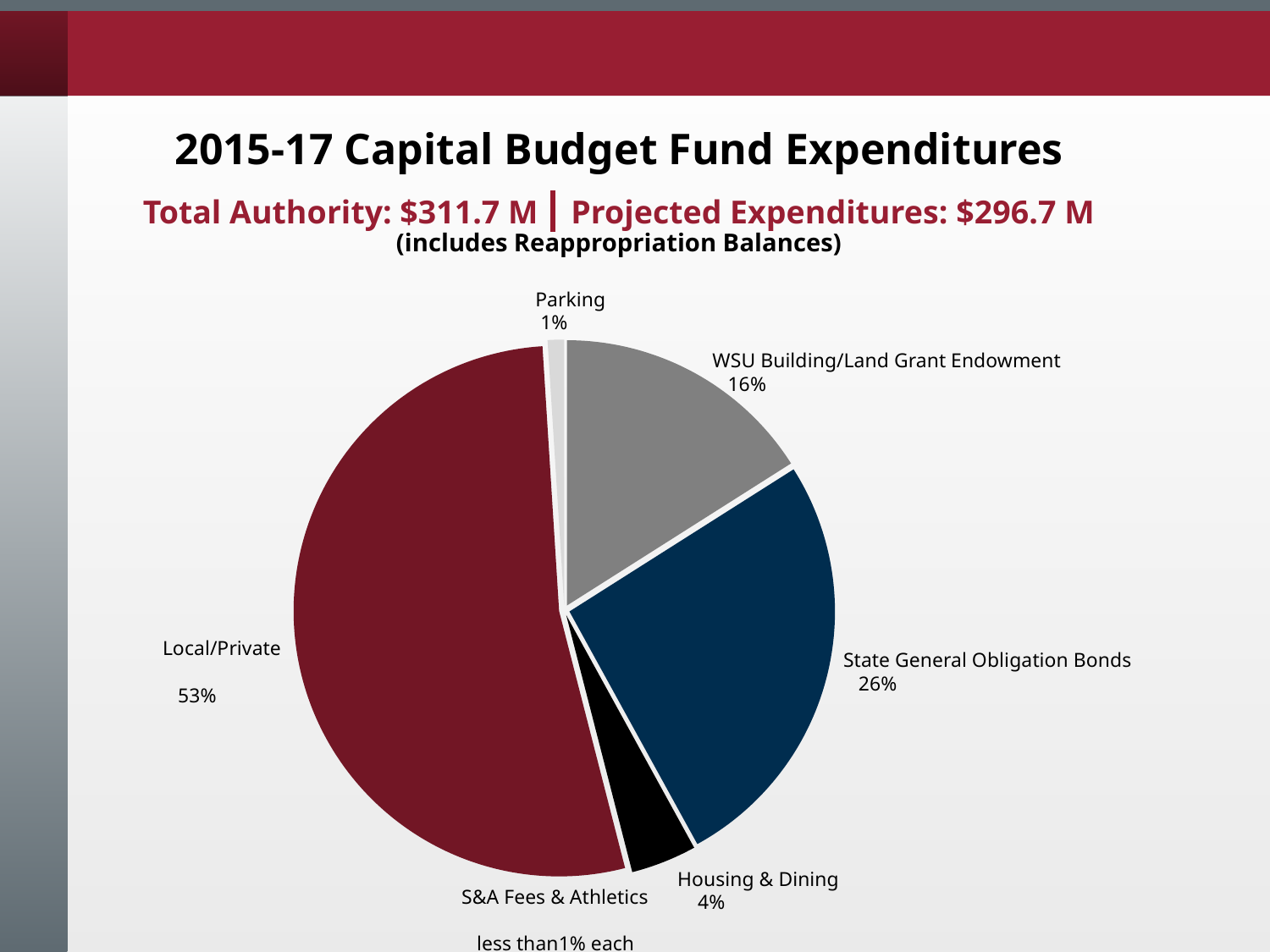
What percentage is shown for State General Obligation Bonds? 26% What is the difference in percentage points between Local/Private and State General Obligation Bonds? 27 What percentage is shown for Parking? 1% What kind of chart is shown on the slide? Pie chart Which is larger, the share for Housing & Dining or the share for Parking? Housing & Dining What percentage is shown for Housing & Dining? 4% What does the label for S&A Fees & Athletics say about its share? less than 1% each What percentage is shown for WSU Building/Land Grant Endowment? 16% Which category has the largest slice of the pie? Local/Private Which is larger, the share for State General Obligation Bonds or the share for WSU Building/Land Grant Endowment? State General Obligation Bonds What share of the pie does Local/Private account for? 53% What is the title of the slide containing the chart? 2015-17 Capital Budget Fund Expenditures